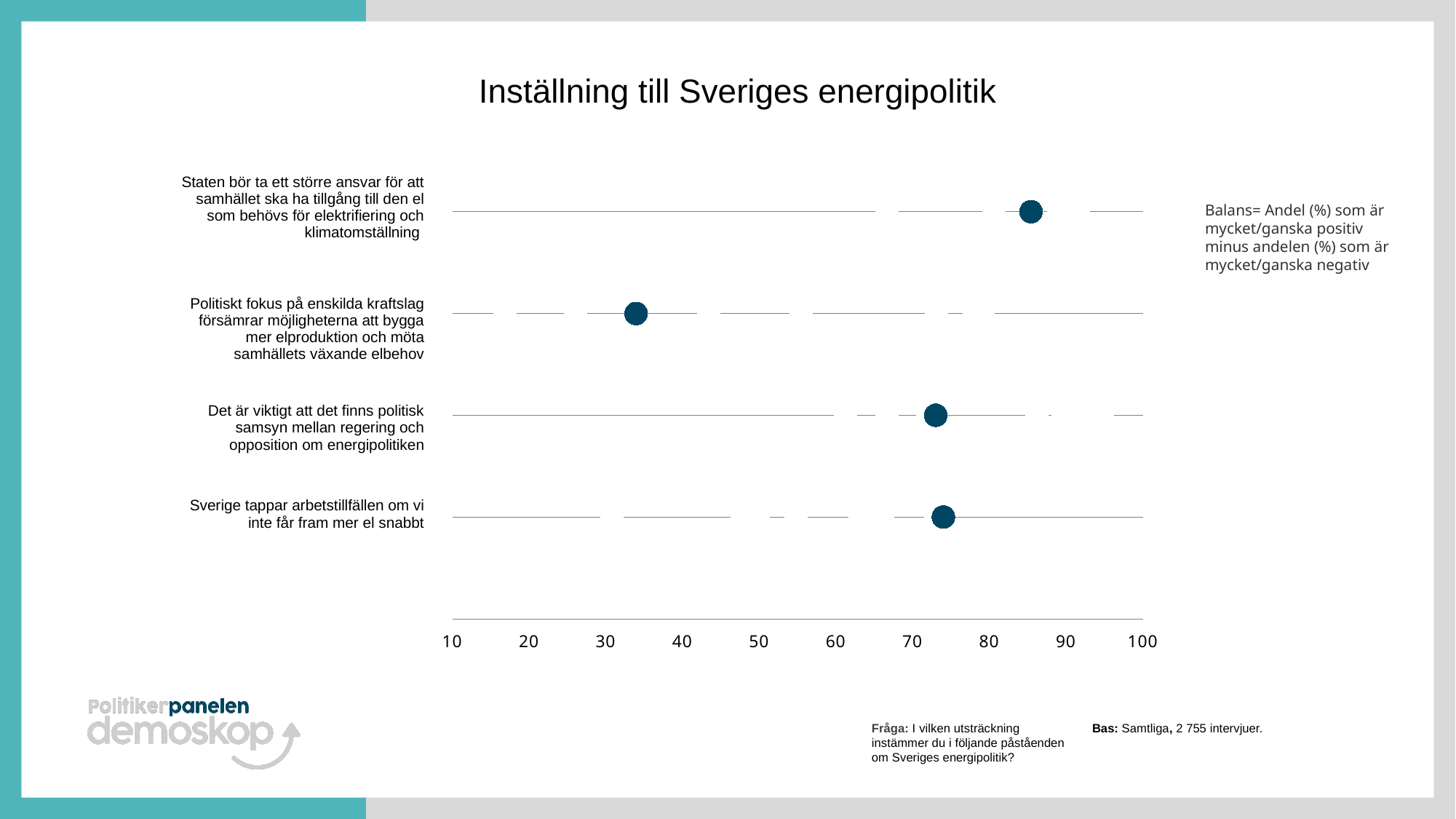
Is the value for 'Politiskt fokus på enskilda kraftslag...' greater or less than 40? less What is the title of the chart? Inställning till Sveriges energipolitik Which statement has the highest balance value? Staten bör ta ett större ansvar för att samhället ska ha tillgång till den el som behövs för elektrifiering och klimatomställning Is the value for 'Staten bör ta ett större ansvar...' greater or less than 80? greater How many statements (categories) are plotted in the chart? 4 What kind of chart is shown on the slide? Dot plot What is the highest value shown on the x axis? 100 Which has a larger value: 'Staten bör ta ett större ansvar...' or 'Politiskt fokus på enskilda kraftslag...'? Staten bör ta ett större ansvar... Which has a larger value: 'Politiskt fokus på enskilda kraftslag...' or 'Sverige tappar arbetstillfällen...'? Sverige tappar arbetstillfällen... Is the value for 'Sverige tappar arbetstillfällen om vi inte får fram mer el snabbt' greater or less than 80? less Which statement has the lowest balance value? Politiskt fokus på enskilda kraftslag försämrar möjligheterna att bygga mer elproduktion och möta samhällets växande elbehov